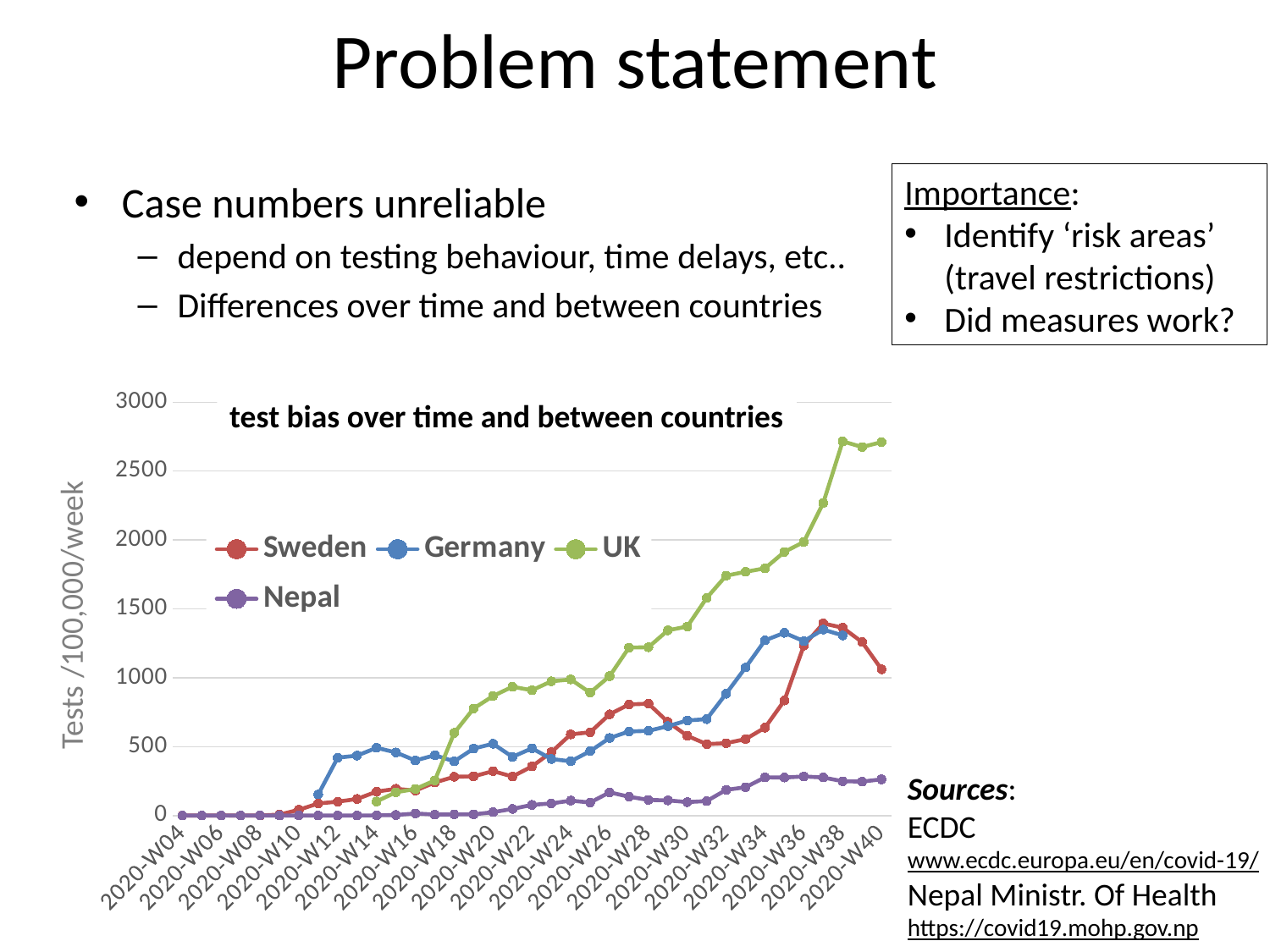
Which series has the lowest value at 2020-W40? Nepal What is the title of the chart? test bias over time and between countries What kind of chart is shown on the slide? line chart Does the UK series generally rise or fall from 2020-W04 to 2020-W40? rise At 2020-W20, which is larger, the value for UK or the value for Sweden? UK Which countries are listed in the chart's legend? Sweden, Germany, UK, Nepal How many series does the chart's legend list? 4 Is the value for Sweden at 2020-W28 greater or less than 500? greater Is the value for Nepal at 2020-W40 greater or less than 500? less Which series has the highest value at 2020-W40? UK Is the value for UK at 2020-W40 greater or less than 2500? greater